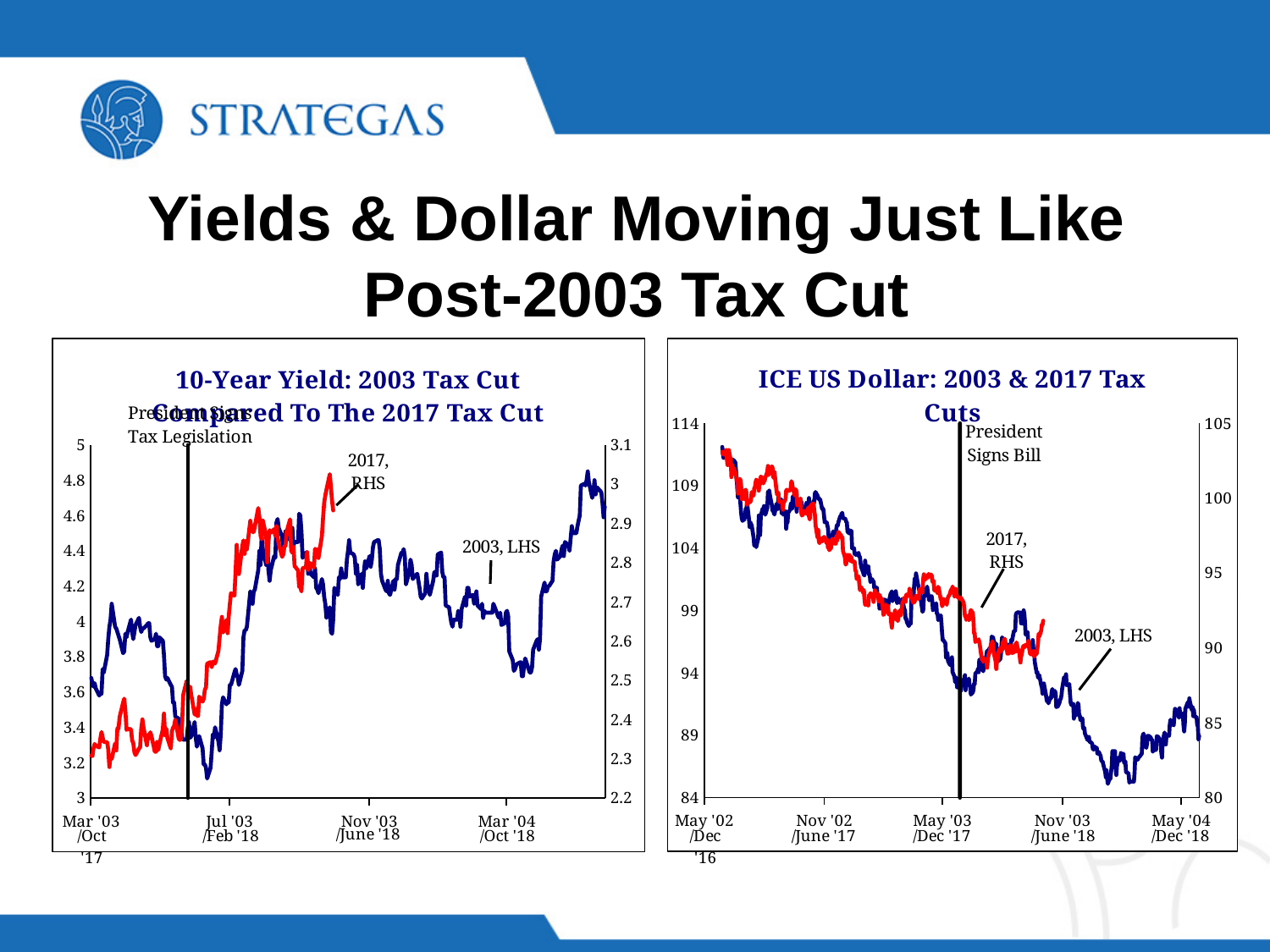
On the left chart, '10-Year Yield: 2003 Tax Cut Compared To The 2017 Tax Cut', is the 2003 (LHS) value at Mar '03 greater or less than 4? less How many series are plotted on the left chart, '10-Year Yield: 2003 Tax Cut Compared To The 2017 Tax Cut'? 2 On the left chart, '10-Year Yield: 2003 Tax Cut Compared To The 2017 Tax Cut', which colour is the 2017 (RHS) line? Red On the left chart, '10-Year Yield: 2003 Tax Cut Compared To The 2017 Tax Cut', does the 2003 (LHS) line rise or fall overall from Mar '03 to the end of the series? Rise On the right chart, 'ICE US Dollar: 2003 & 2017 Tax Cuts', is the 2017 (RHS) value at the end of its series greater or less than 95? less On the right chart, 'ICE US Dollar: 2003 & 2017 Tax Cuts', is the 2003 (LHS) value at May '02 greater or less than 109? greater What kind of chart is the left chart, '10-Year Yield: 2003 Tax Cut Compared To The 2017 Tax Cut'? Line chart On the right chart, 'ICE US Dollar: 2003 & 2017 Tax Cuts', what event does the vertical black line mark? President Signs Bill How many series are plotted on the right chart, 'ICE US Dollar: 2003 & 2017 Tax Cuts'? 2 What kind of chart is the right chart, 'ICE US Dollar: 2003 & 2017 Tax Cuts'? Line chart On the right chart, 'ICE US Dollar: 2003 & 2017 Tax Cuts', does the 2003 (LHS) line rise or fall overall from May '02 to May '04? Fall